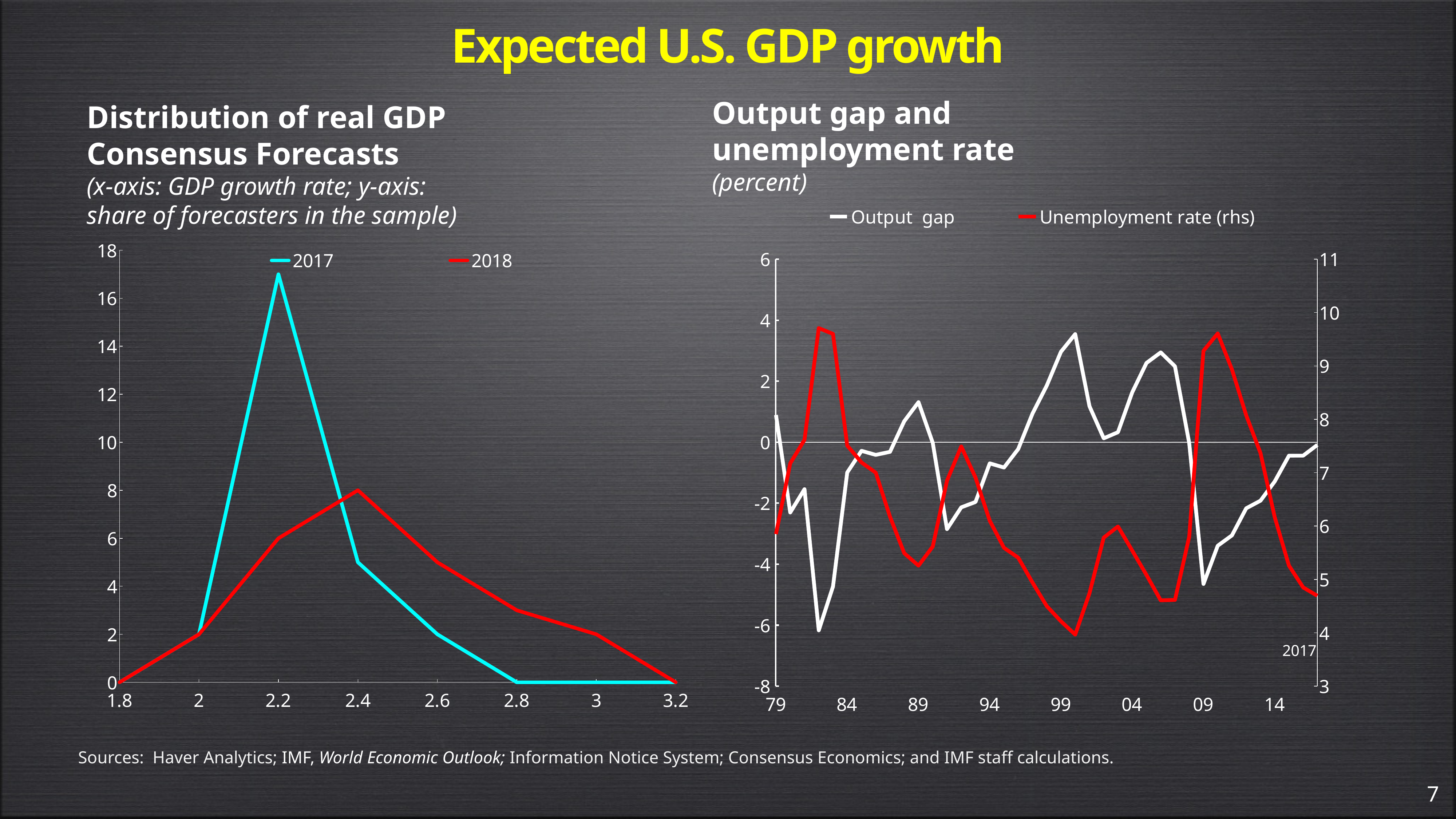
In the 'Distribution of real GDP Consensus Forecasts' chart, what is the value of the 2018 series at a GDP growth rate of 2.4? 8 In the 'Distribution of real GDP Consensus Forecasts' chart, at a GDP growth rate of 2.6, which series has the larger value, 2017 or 2018? 2018 In the 'Distribution of real GDP Consensus Forecasts' chart, at which GDP growth rate does the 2017 series reach its highest value? 2.2 How many series does the legend of the 'Output gap and unemployment rate' chart list? 2 In the 'Distribution of real GDP Consensus Forecasts' chart, at a GDP growth rate of 2.2, which series has the larger value, 2017 or 2018? 2017 In the 'Output gap and unemployment rate' chart, which series is plotted on the right-hand axis? Unemployment rate What kind of chart is the 'Distribution of real GDP Consensus Forecasts' chart? line chart In the 'Output gap and unemployment rate' chart, is the unemployment rate around 2010 greater or less than 9? greater How many series does the legend of the 'Distribution of real GDP Consensus Forecasts' chart list? 2 In the 'Distribution of real GDP Consensus Forecasts' chart, what is the value of the 2017 series at a GDP growth rate of 2.8? 0 In the 'Distribution of real GDP Consensus Forecasts' chart, is the value of the 2017 series at 2.2 greater or less than 16? greater In the 'Distribution of real GDP Consensus Forecasts' chart, at which GDP growth rate does the 2018 series reach its highest value? 2.4